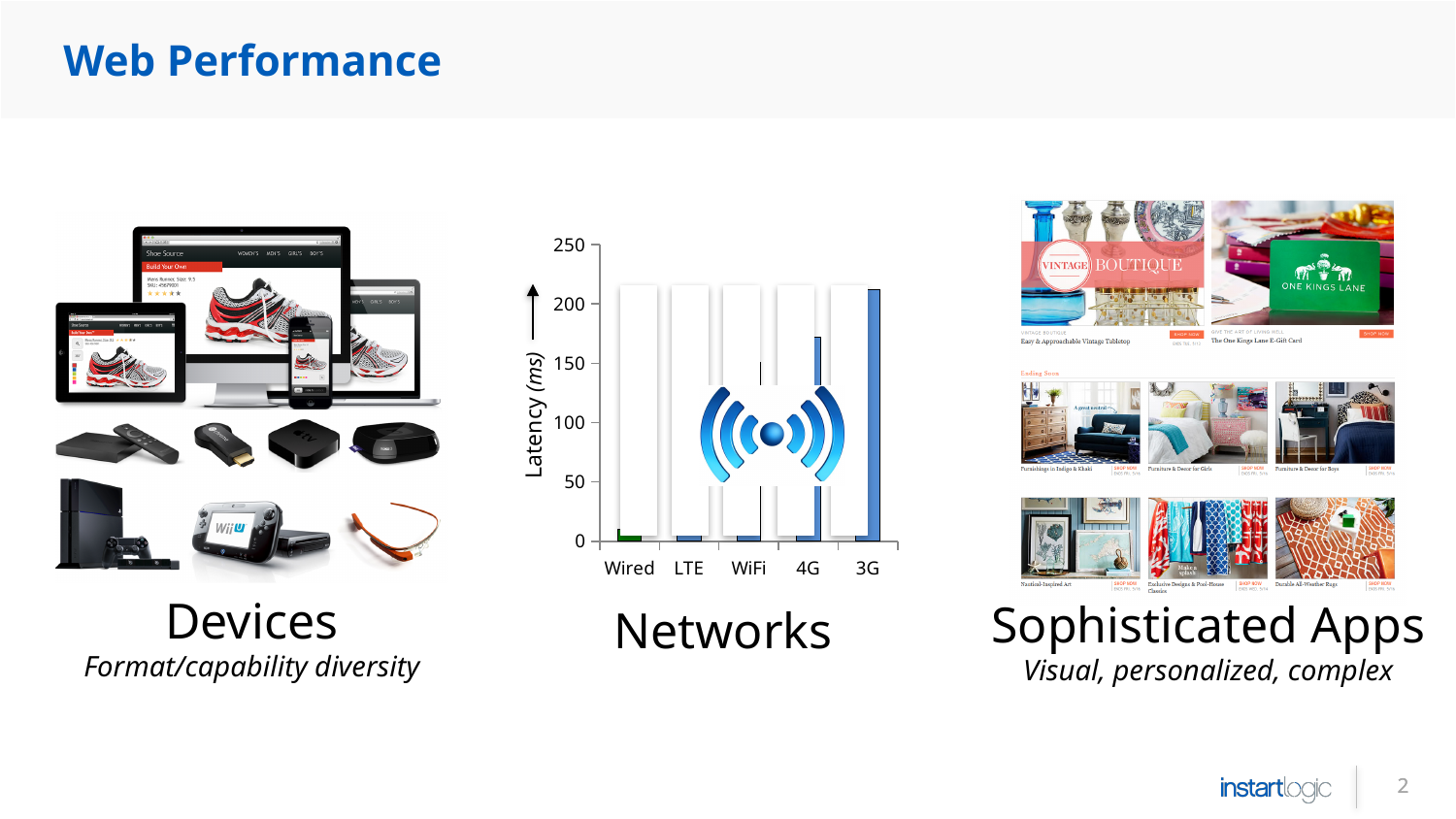
Is the latency value for 4G greater or less than 200? less Which network has the highest latency in the chart? 3G What is the highest tick value shown on the y axis of the latency chart? 250 What kind of chart is shown in the Networks section of the slide? bar chart Is the latency value for 4G greater or less than 150? greater Which has the larger latency in the chart, 4G or WiFi? 4G Is the latency value for 3G greater or less than 200? greater What is the label on the y axis of the latency chart? Latency (ms) Which has the larger latency in the chart, 3G or 4G? 3G How many network categories are plotted on the x axis of the latency chart? 5